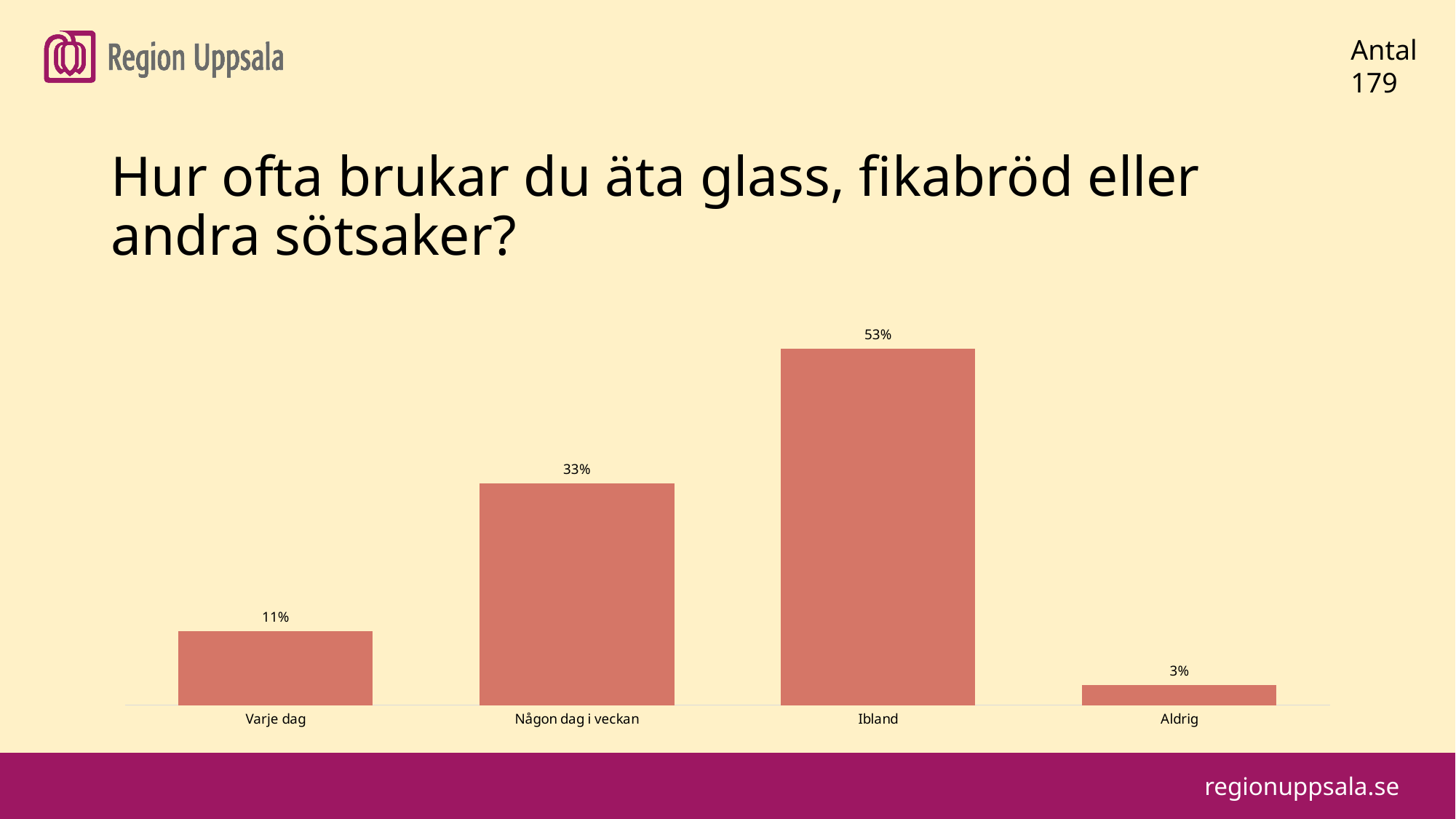
What is the value for Någon dag i veckan? 33% What is the value for Ibland? 53% What kind of chart is shown on the slide? Bar chart What is the value for Aldrig? 3% Which is larger, the value for Varje dag or the value for Någon dag i veckan? Någon dag i veckan How many categories are shown in the chart? 4 Which category has the lowest value? Aldrig What is the value for Varje dag? 11% What is the difference between the values for Ibland and Någon dag i veckan? 20% Which category has the highest value? Ibland What is the number of respondents (Antal) shown on the slide? 179 What is the difference between the values for Varje dag and Aldrig? 8%